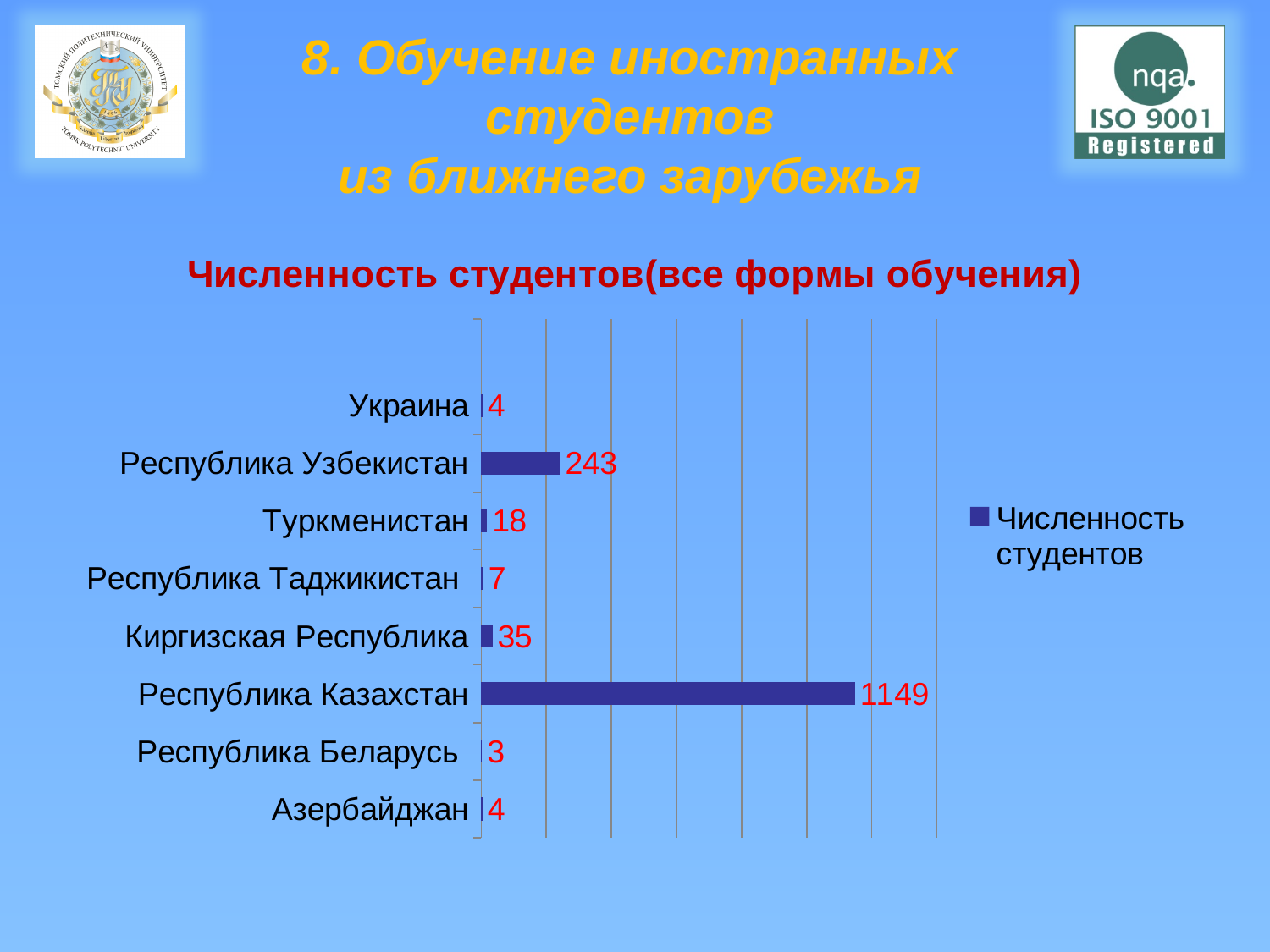
What is the number of students from Республика Узбекистан? 243 Which country has the lowest number of students? Республика Беларусь How many series does the legend list? 1 Which has more students, Киргизская Республика or Туркменистан? Киргизская Республика Which country has the highest number of students? Республика Казахстан What is the title of the chart? Численность студентов(все формы обучения) What kind of chart is shown on the slide? bar chart What is the difference between the number of students from Республика Казахстан and Республика Узбекистан? 906 What is the number of students from Киргизская Республика? 35 What is the number of students from Туркменистан? 18 How many countries are shown in the chart? 8 What is the number of students from Республика Казахстан? 1149